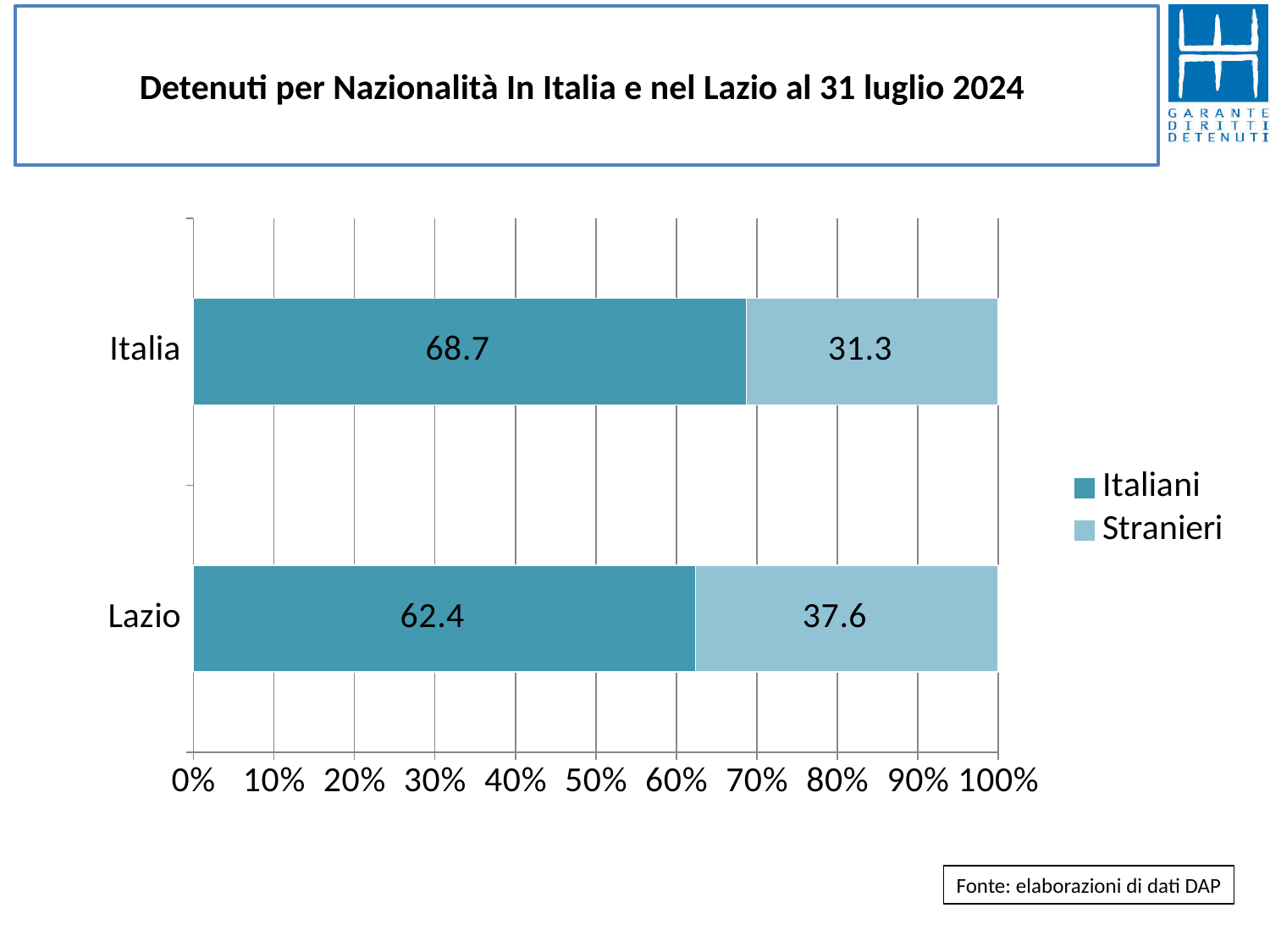
Is the value for Italiani in Lazio greater or less than 60%? greater What is the value for Stranieri in Italia? 31.3 Which category has the highest value for Italiani? Italia How many series does the legend list? 2 What is the difference between the Italiani values for Italia and Lazio? 6.3 What is the difference between the Italiani and Stranieri values for Lazio? 24.8 What is the value for Italiani in Lazio? 62.4 What is the value for Italiani in Italia? 68.7 What is the value for Stranieri in Lazio? 37.6 Which category has the higher value for Stranieri, Italia or Lazio? Lazio What kind of chart is shown on the slide? Stacked bar chart How many categories are shown on the chart? 2